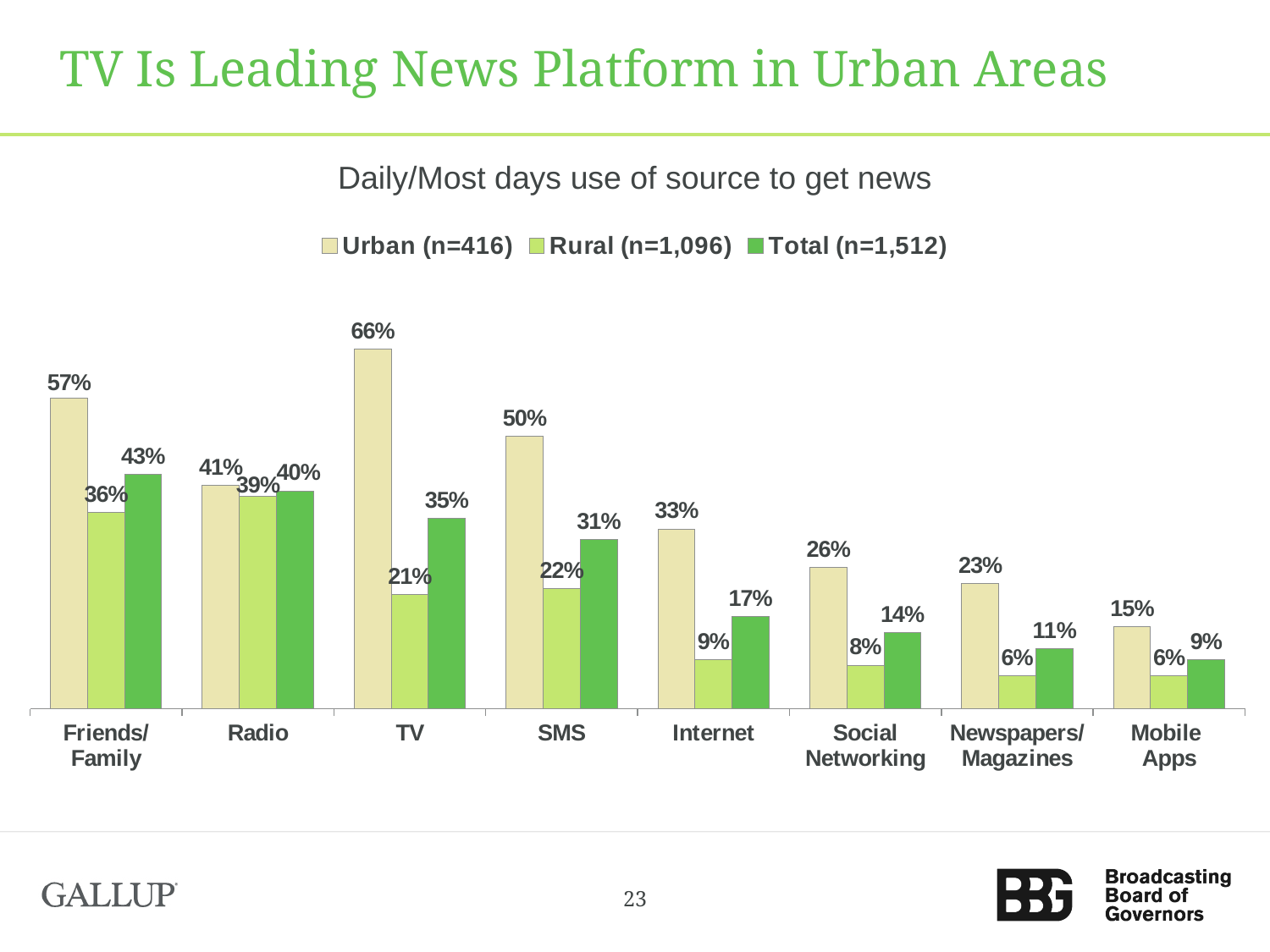
What is the subtitle above the chart? Daily/Most days use of source to get news What is the Total value for Internet? 17% What kind of chart is shown on the slide? Bar chart What is the difference between the Urban and Rural values for TV? 45% What is the Urban value for TV? 66% What is the Rural value for Friends/Family? 36% What is the sample size for the Rural series shown in the legend? 1,096 Which news source has the lowest Total value? Mobile Apps Which news source has the highest Urban value? TV How many series does the legend list? 3 How many news source categories are shown on the x axis? 8 Which is larger for Radio: the Urban value or the Rural value? Urban